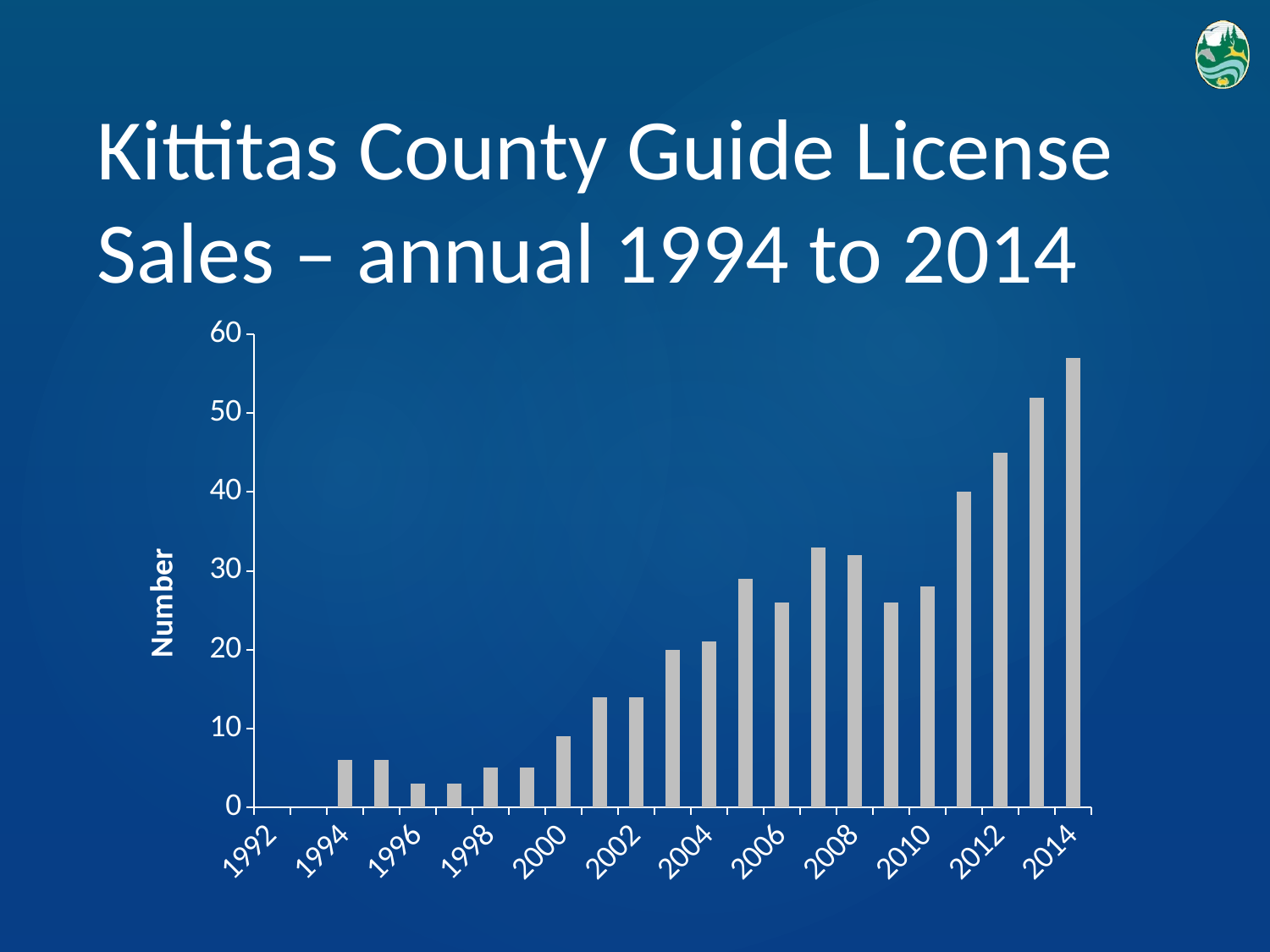
Is the value for 2012 greater or less than 40? greater Which year has the larger value, 2007 or 2009? 2007 Is the value for 2014 greater or less than 50? greater Is the value for 2007 greater or less than 30? greater What is the label on the vertical axis of the chart? Number Which year has the highest number of guide license sales? 2014 Which year has the larger value, 2013 or 2010? 2013 What kind of chart is shown on the slide? bar chart How many years (bars) are plotted in the chart? 21 Overall, do the values rise or fall from 1994 to 2014? rise